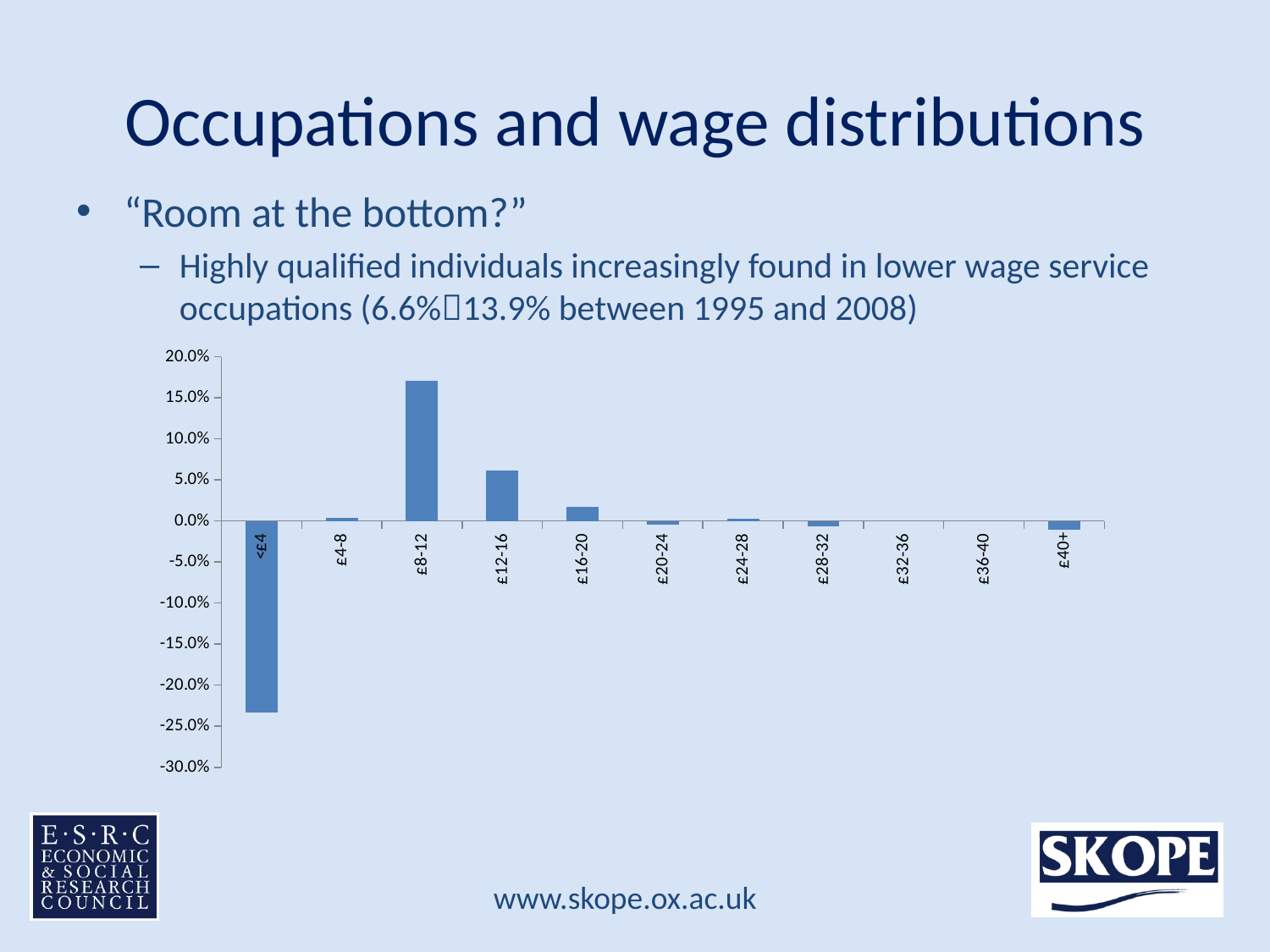
Is the value for <£4 greater or less than 0.0%? less Is the value for £16-20 greater or less than 5.0%? less What kind of chart is shown on the slide? bar chart Is the value for £8-12 greater or less than 15.0%? greater Which has the larger value, £8-12 or £12-16? £8-12 Which wage category has the highest value in the chart? £8-12 Which has the larger value, £12-16 or £16-20? £12-16 Which wage category has the lowest value in the chart? <£4 How many wage categories are shown along the x axis of the chart? 11 What is the lowest value shown on the chart's y axis? -30.0%